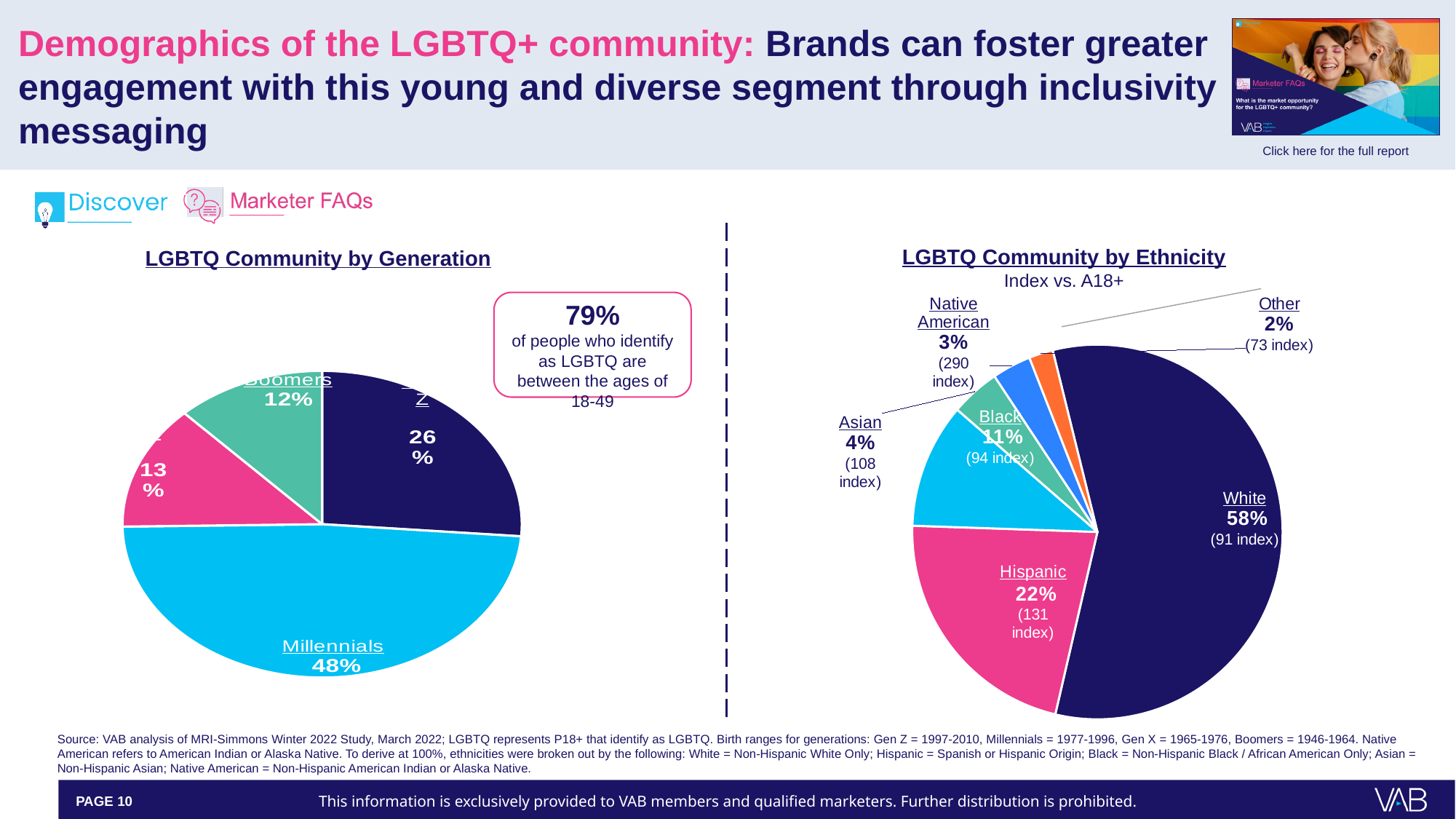
In the LGBTQ Community by Ethnicity chart, what share of the LGBTQ community is White? 58% In the LGBTQ Community by Ethnicity chart, how many ethnicity categories are shown? 6 In the LGBTQ Community by Generation chart, how many slices does the pie have? 4 In the LGBTQ Community by Ethnicity chart, what is the index vs. A18+ for Native American? 290 index In the LGBTQ Community by Generation chart, which generation has the largest slice? Millennials In the LGBTQ Community by Ethnicity chart, what is the difference in share between White and Hispanic? 36% What kind of chart is the LGBTQ Community by Generation chart? Pie chart In the LGBTQ Community by Generation chart, what share of the LGBTQ community are Boomers? 12% In the LGBTQ Community by Ethnicity chart, what share of the LGBTQ community is Hispanic? 22% In the LGBTQ Community by Generation chart, what share of the LGBTQ community are Millennials? 48% In the LGBTQ Community by Ethnicity chart, which is larger, the Black share or the Asian share? Black In the LGBTQ Community by Ethnicity chart, which ethnicity has the smallest slice? Other